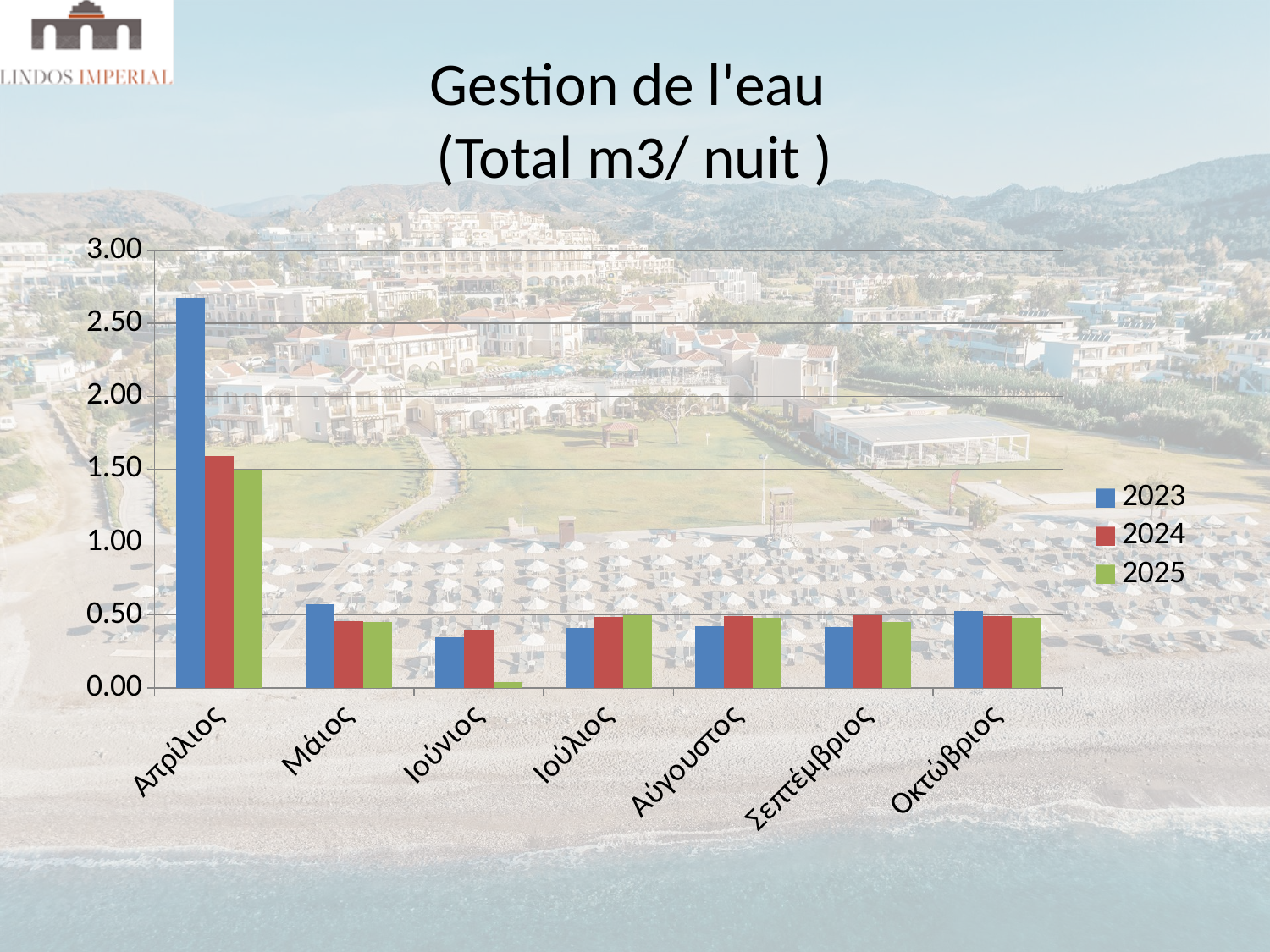
Which month has the lowest value for the 2025 series? Ιούνιος Is the 2023 value for Ιούνιος greater or less than 0.50? less How many months (categories) are shown on the x axis? 7 How many series does the legend list? 3 Is the 2025 value for Ιούνιος greater or less than 0.50? less For Ιούνιος, which series has the larger value, 2023 or 2025? 2023 Is the 2024 value for Απρίλιος greater or less than 1.00? greater Which colour represents the 2025 series in the legend? Green What kind of chart is shown on the slide? Bar chart For Απρίλιος, which series has the larger value, 2023 or 2024? 2023 Which month has the highest value for the 2023 series? Απρίλιος